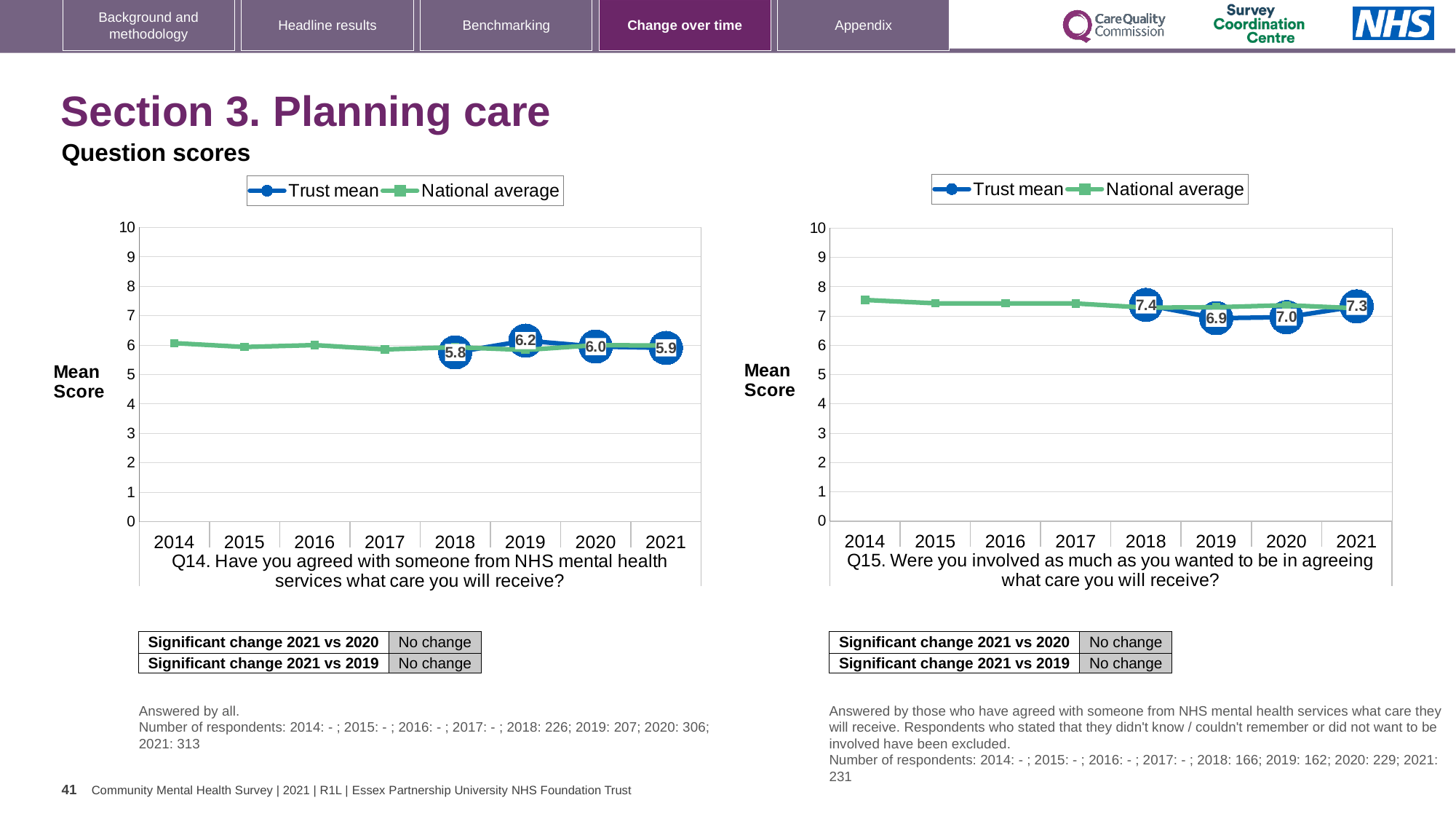
In the Q14 chart on the left, which year has the lowest labelled Trust mean? 2018 In the Q15 chart on the right, is the Trust mean for 2021 larger or smaller than the Trust mean for 2019? larger In the Q14 chart on the left, what is the Trust mean for 2021? 5.9 In the Q15 chart on the right, what is the Trust mean for 2020? 7.0 In the Q14 chart on the left, which year has the highest labelled Trust mean? 2019 In the Q15 chart on the right, which year has the lowest labelled Trust mean? 2019 In the Q14 chart on the left, what is the Trust mean for 2019? 6.2 How many series does the legend of the Q14 chart on the left list? 2 In the Q14 chart on the left, what is the difference between the Trust mean for 2019 and the Trust mean for 2018? 0.4 In the Q15 chart on the right, what is the Trust mean for 2018? 7.4 In the Q15 chart on the right, is the National average for 2014 greater or less than 7? greater What type of chart is the Q15 chart on the right? line chart